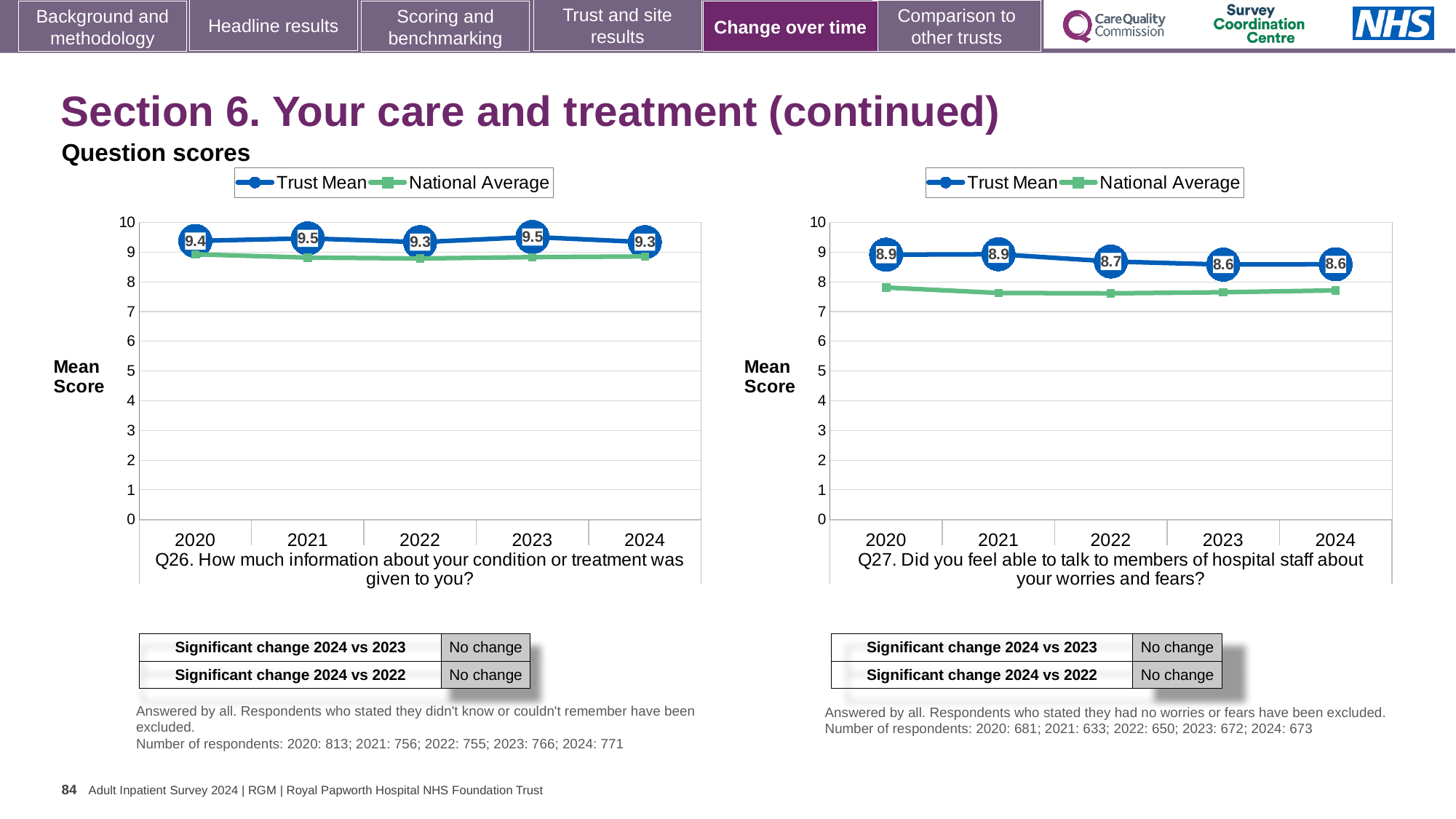
In the Q27 chart (right), what is the Trust Mean score for 2023? 8.6 In the Q26 chart (left), is the National Average value for 2020 greater or less than 8? greater In the Q26 chart (left), what is the Trust Mean score for 2024? 9.3 What kind of chart is used for Q27 (right)? Line chart In the Q26 chart (left), which is larger, the Trust Mean score for 2021 or for 2022? 2021 In the Q26 chart (left), what is the Trust Mean score for 2021? 9.5 How many years are plotted on the x axis of the Q26 chart (left)? 5 In the Q27 chart (right), what is the Trust Mean score for 2020? 8.9 In the Q27 chart (right), which year has the lowest Trust Mean score? 2023 and 2024 (8.6) How many series does the legend of the Q27 chart (right) list? 2 In the Q27 chart (right), what is the difference between the Trust Mean score in 2020 and in 2024? 0.3 In the Q27 chart (right), is the National Average value for 2021 greater or less than 8? less